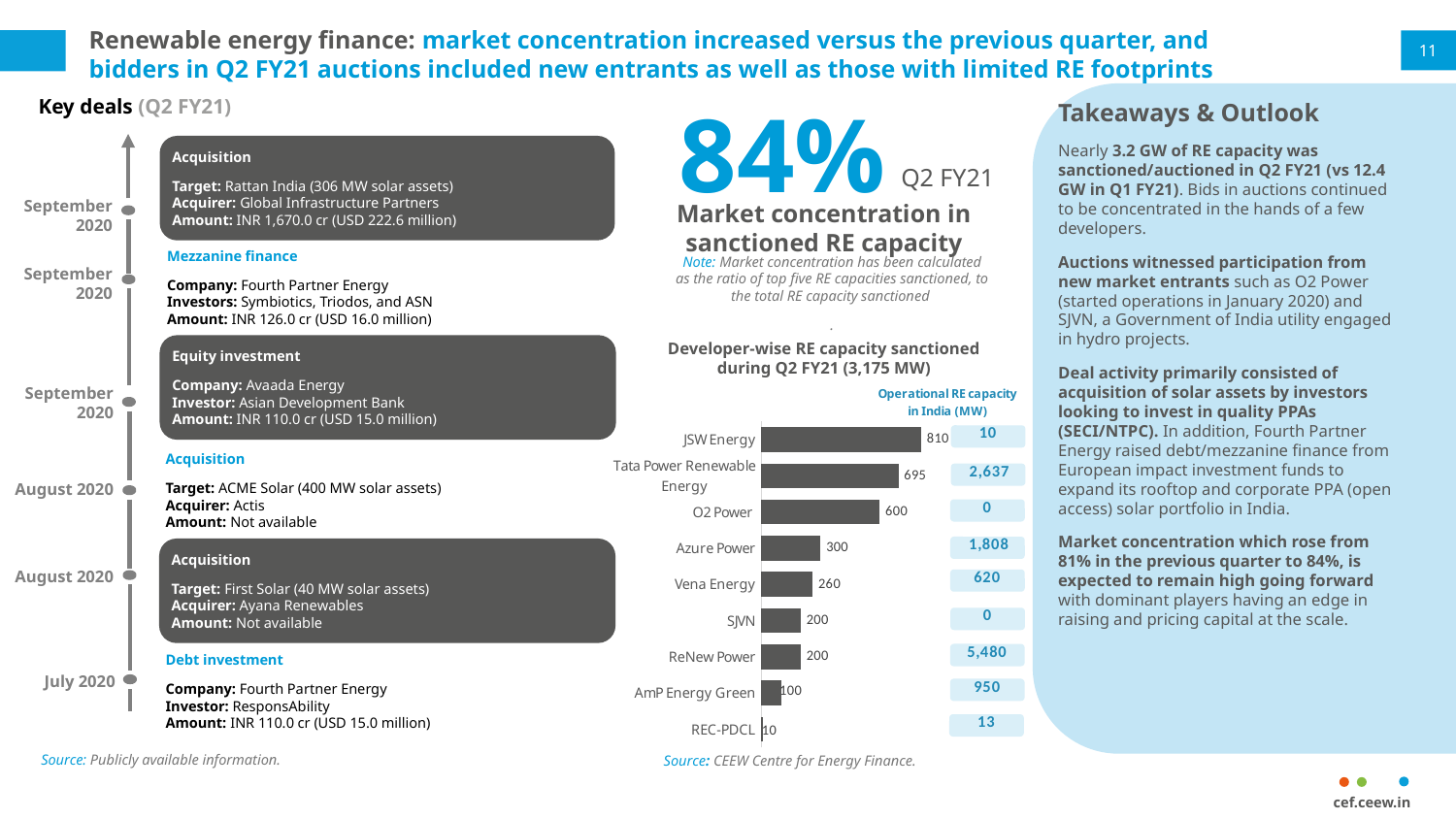
In the developer-wise chart, which has a larger sanctioned capacity: Azure Power or AmP Energy Green? Azure Power What is the difference between the sanctioned capacity of JSW Energy and Tata Power Renewable Energy in the developer-wise chart? 115 What is the RE capacity sanctioned for Vena Energy in the developer-wise chart? 260 According to the column beside the chart, what is the operational RE capacity in India (MW) for Tata Power Renewable Energy? 2,637 How many developers are shown in the developer-wise RE capacity sanctioned chart? 9 Which developer has the lowest RE capacity sanctioned in the developer-wise chart? REC-PDCL Which developer has the highest RE capacity sanctioned in the developer-wise chart? JSW Energy What is the RE capacity sanctioned for O2 Power in the developer-wise chart? 600 What is the RE capacity sanctioned for JSW Energy in the developer-wise chart? 810 What kind of chart is used to show developer-wise RE capacity sanctioned during Q2 FY21? Bar chart According to the column beside the chart, what is the operational RE capacity in India (MW) for ReNew Power? 5,480 What is the total RE capacity sanctioned during Q2 FY21 stated in the chart title? 3,175 MW